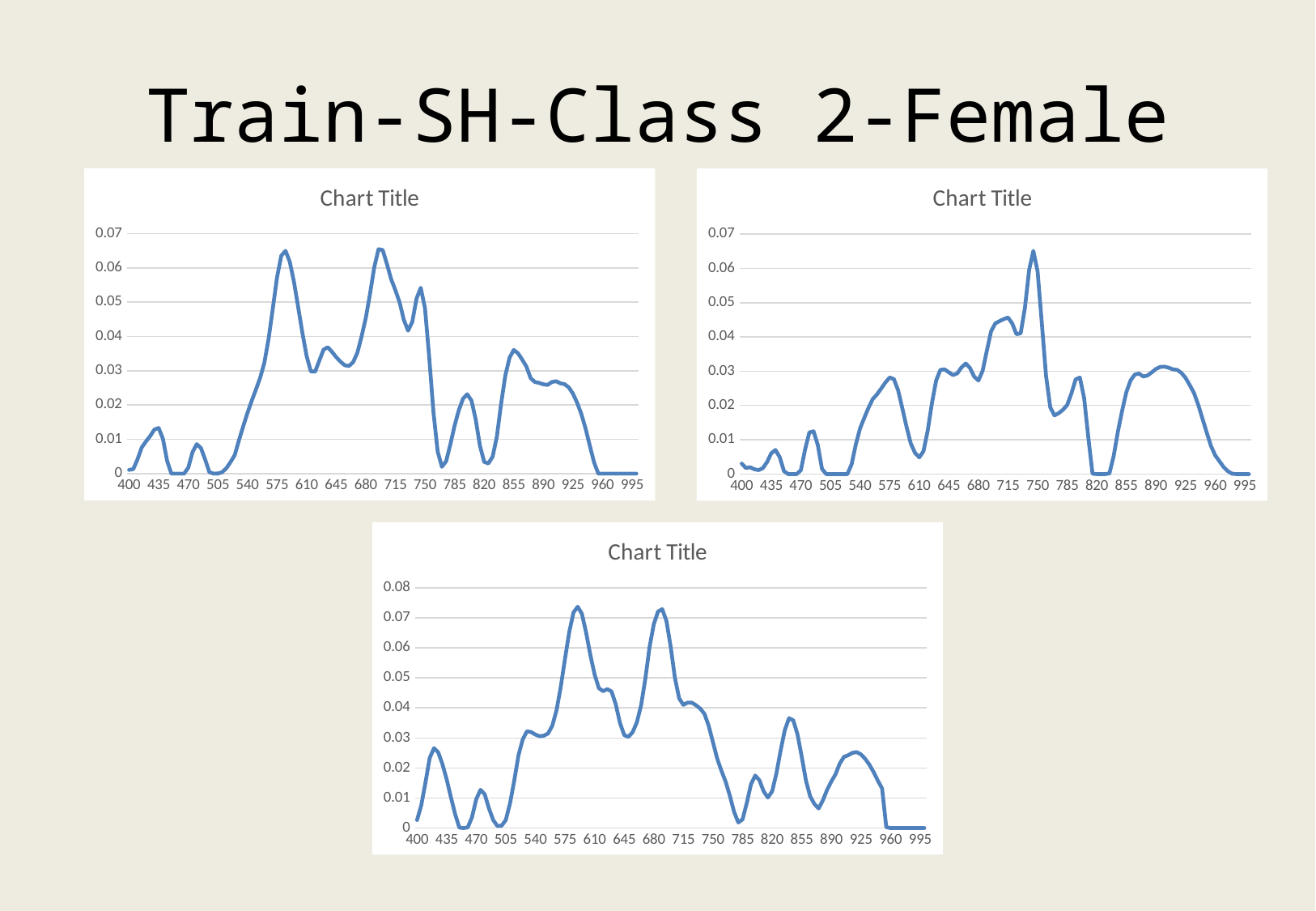
How many x-axis tick labels are shown on the bottom chart? 18 In the top-right chart, does the line rise or fall between 925 and 995? fall In the bottom chart, is the value at 855 greater or less than 0.02? greater In the top-left chart, is the value at 855 greater or less than 0.02? greater What kind of chart is the top-left chart? line chart In the top-right chart, is the value at 820 greater or less than 0.01? less What is the title shown on each of the three charts? Chart Title How many charts are on the slide? 3 What kind of chart is the bottom chart? line chart